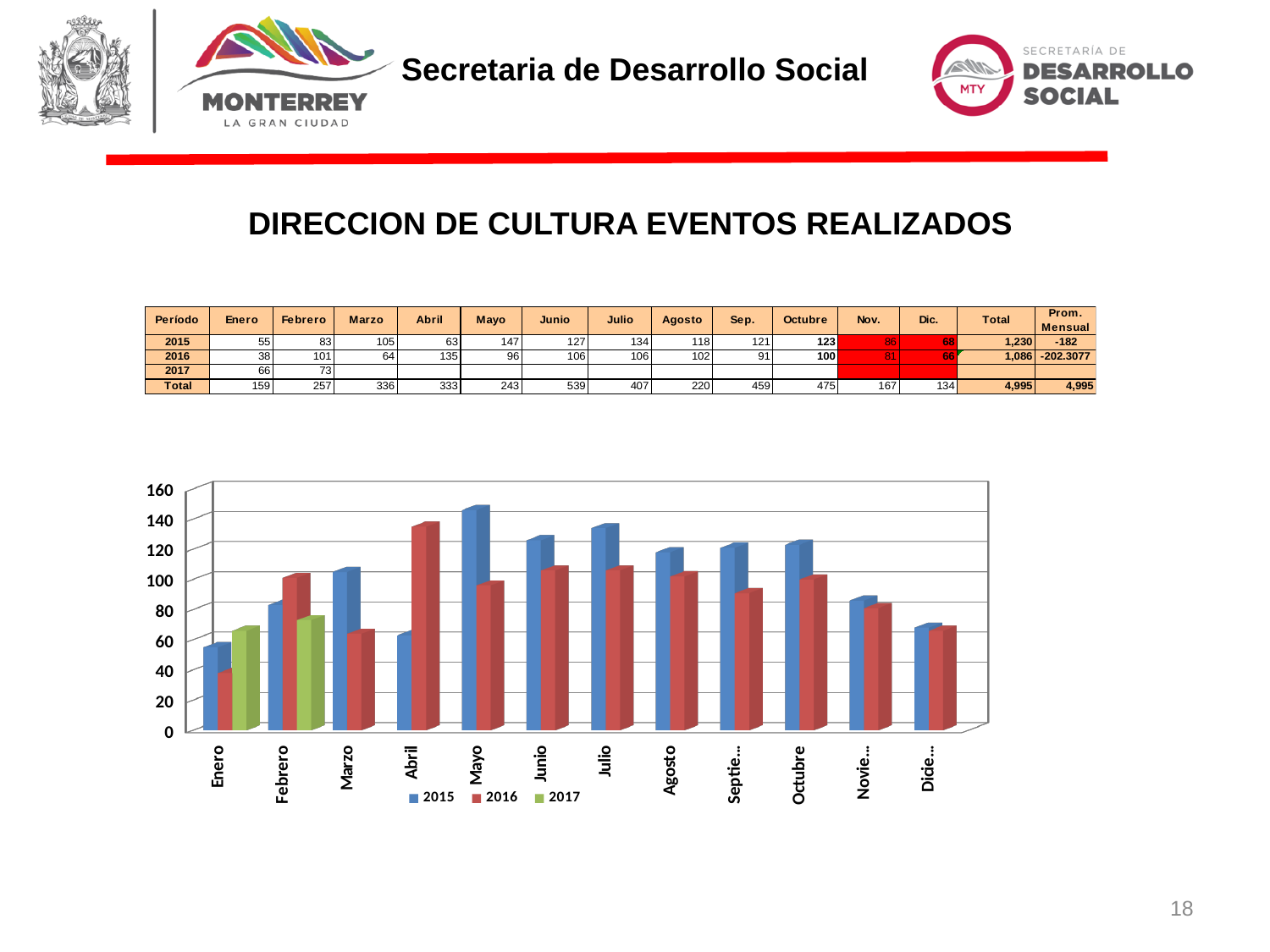
According to the table, what is the 2015 value for Mayo? 147 Which month has the highest value for the 2015 series? Mayo Which month has the lowest value for the 2016 series? Enero Which series is shown in green in the chart legend? 2017 According to the table, what is the difference between the 2016 and 2015 values for Abril? 72 How many month categories are shown along the x axis of the chart? 12 Is the 2015 value for Mayo greater or less than 140? greater What kind of chart is shown on the slide? bar chart Is the 2016 value for Enero greater or less than 40? less How many series does the chart legend list? 3 Which is larger in Abril, the 2015 value or the 2016 value? 2016 Which is larger in Marzo, the 2015 value or the 2016 value? 2015